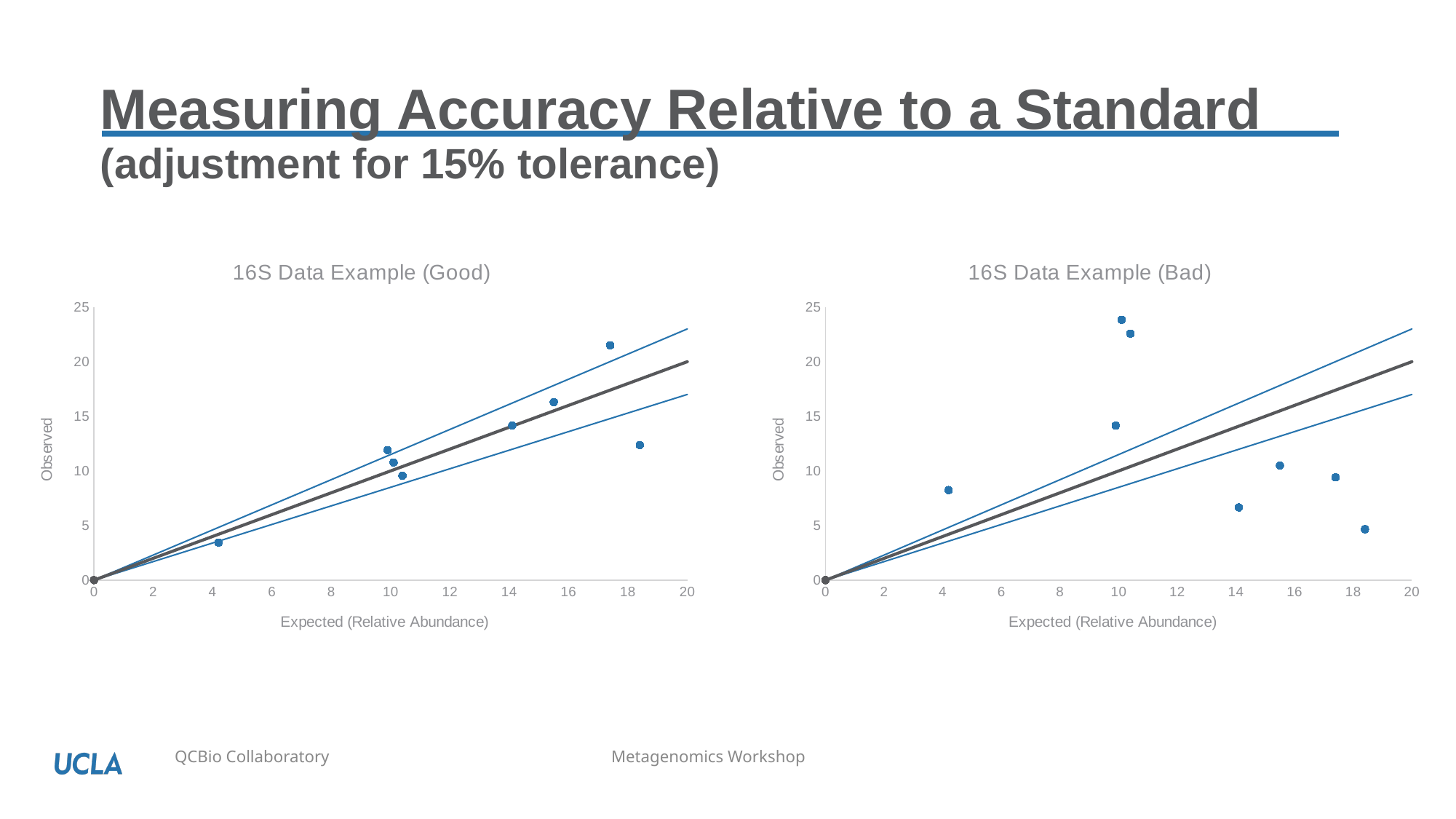
What is the y-axis title of the "16S Data Example (Bad)" chart? Observed In the "16S Data Example (Good)" chart, is the highest observed value greater or less than 20? greater What kind of chart is the "16S Data Example (Bad)" chart? Scatter chart In the "16S Data Example (Good)" chart, is the observed value for the point at an expected value of about 14 greater or less than 10? greater In the "16S Data Example (Bad)" chart, what is the maximum value shown on the y axis? 25 In the "16S Data Example (Bad)" chart, is the observed value for the point at an expected value of about 4 greater or less than 5? greater How many charts are shown on the slide? 2 What kind of chart is the "16S Data Example (Good)" chart? Scatter chart What is the x-axis title of the "16S Data Example (Good)" chart? Expected (Relative Abundance)